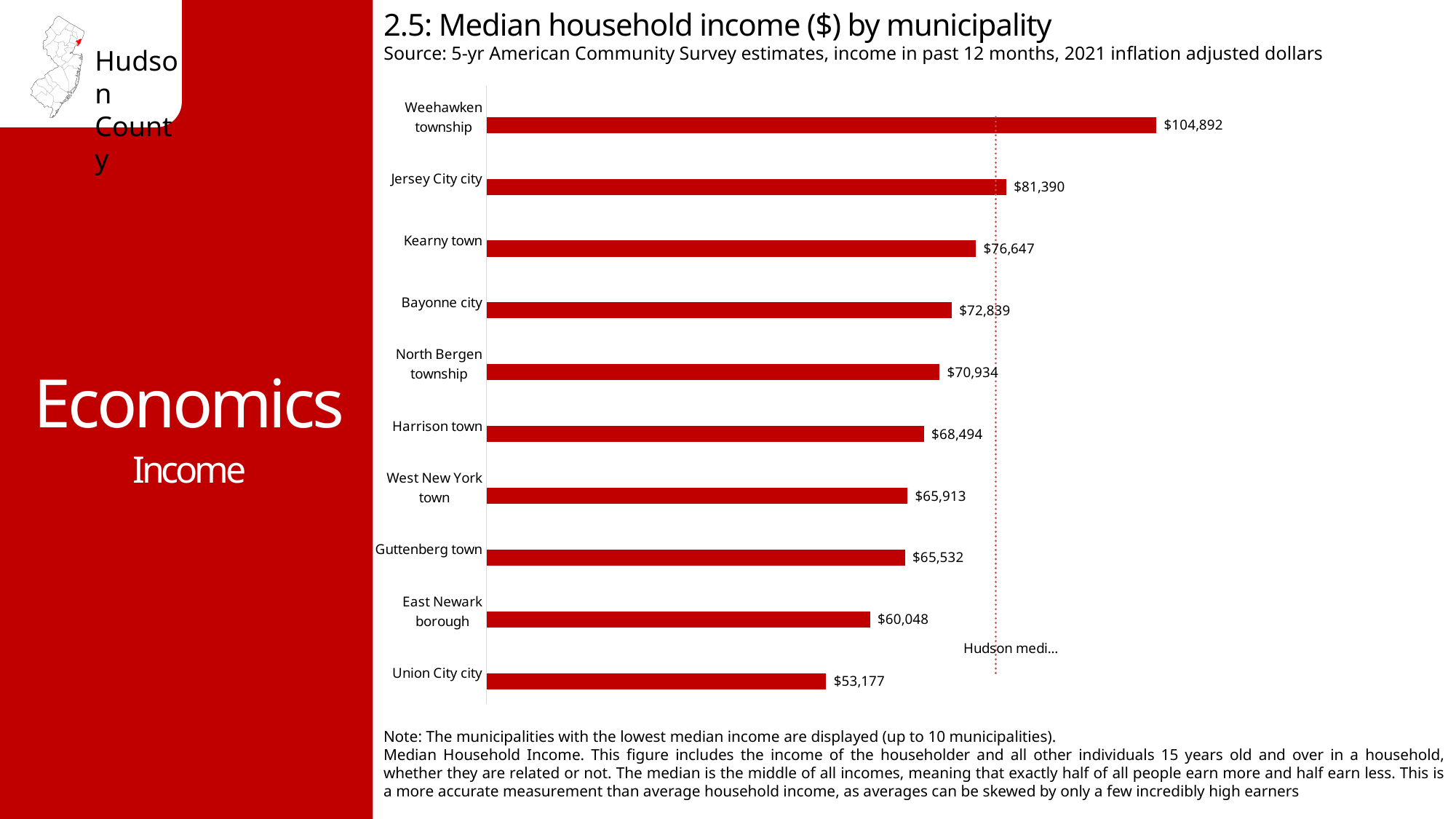
What is the median household income for Union City city? $53,177 What is the difference in median household income between Jersey City city and Kearny town? $4,743 What kind of chart is shown on the slide? Bar chart What is the median household income for Bayonne city? $72,839 Which municipality has the lowest median household income on the chart? Union City city What is the median household income for East Newark borough? $60,048 Which municipality has the highest median household income on the chart? Weehawken township What is the median household income for Weehawken township? $104,892 Which has a higher median household income, Harrison town or East Newark borough? Harrison town How many municipalities are shown on the chart? 10 What is the difference in median household income between Weehawken township and Union City city? $51,715 What is the title of the chart? 2.5: Median household income ($) by municipality